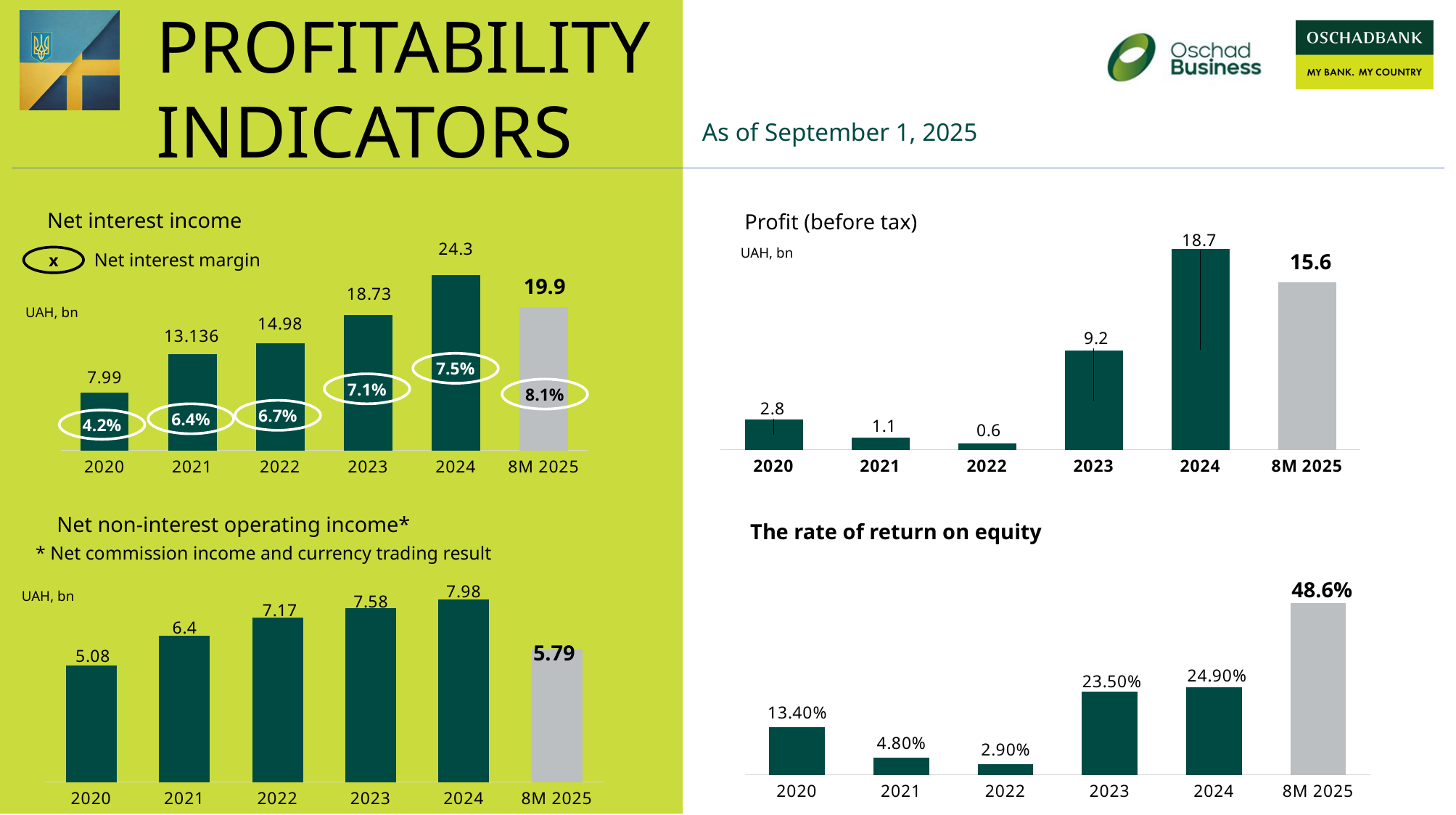
In the Net interest income chart, which year has the highest net interest income? 2024 In the Profit (before tax) chart, which is larger, the value for 2024 or for 8M 2025? 2024 How many periods are shown on the x axis of the Profit (before tax) chart? 6 In the Net interest income chart, what is the net interest margin shown for 8M 2025? 8.1% In the Profit (before tax) chart, what is the value for 2022? 0.6 In The rate of return on equity chart, which period has the highest value? 8M 2025 In the Profit (before tax) chart, what is the difference between the 2024 and 2023 values? 9.5 In the Net non-interest operating income chart, what is the difference between the 2024 and 2020 values? 2.9 In the Net interest income chart, what is the value for 2023? 18.73 In the Net non-interest operating income chart, which period has the lowest value? 2020 In The rate of return on equity chart, what is the value for 2023? 23.50% In the Net non-interest operating income chart, what is the value for 2022? 7.17